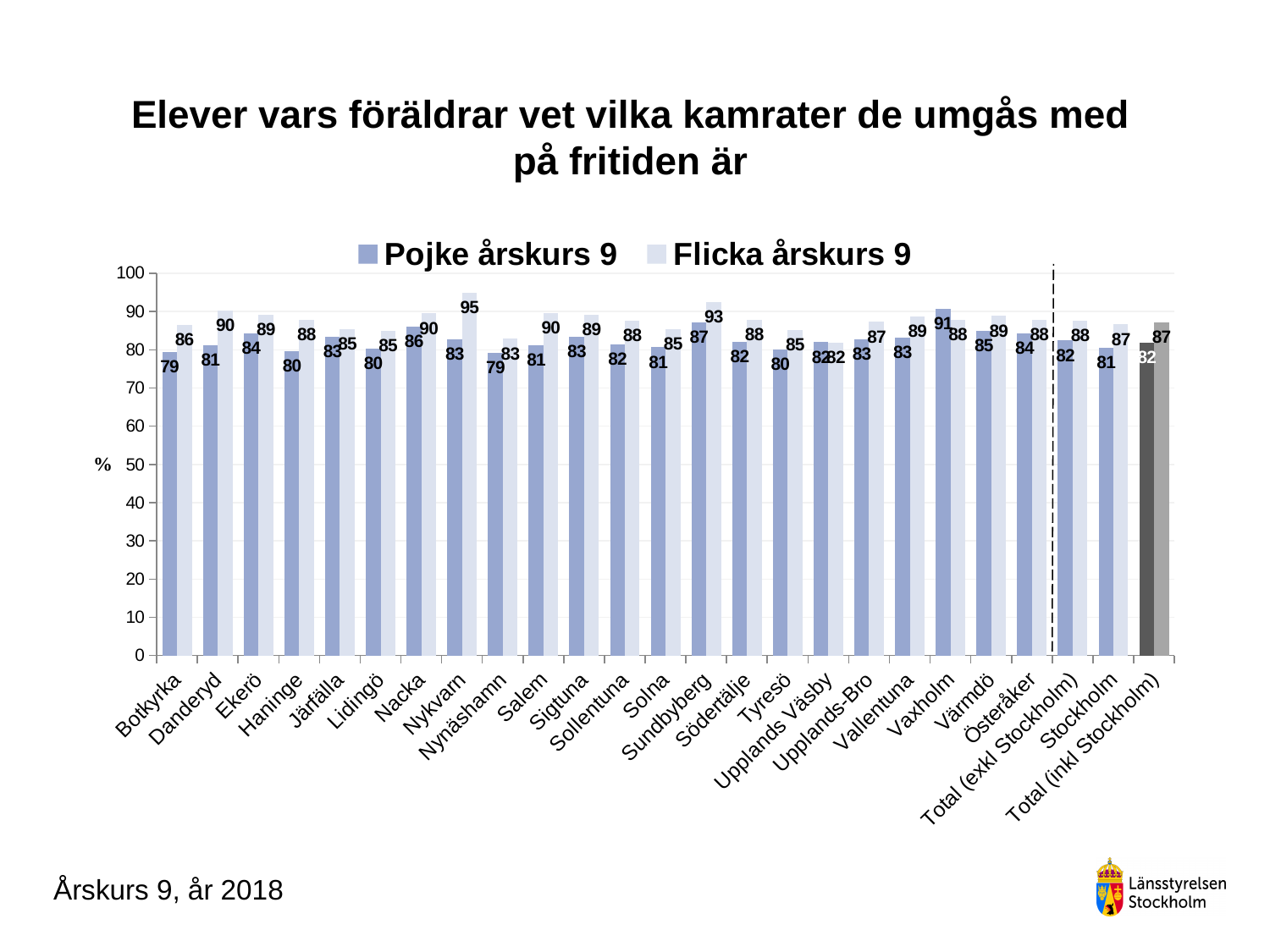
Which category has the highest value for Pojke årskurs 9? Vaxholm What kind of chart is shown on the slide? Bar chart What is the difference between Flicka årskurs 9 and Pojke årskurs 9 in Nykvarn? 12 Which is larger in Vaxholm: Pojke årskurs 9 or Flicka årskurs 9? Pojke årskurs 9 What is the value for Pojke årskurs 9 in Vaxholm? 91 What is the value for Flicka årskurs 9 in Nykvarn? 95 How many series does the legend list? 2 Which municipality has the highest value for Flicka årskurs 9? Nykvarn What is the value for Flicka årskurs 9 for Total (inkl Stockholm)? 87 What is the value for Pojke årskurs 9 in Nykvarn? 83 Which category has the lowest value for Flicka årskurs 9? Upplands Väsby How many categories are shown on the x axis? 25